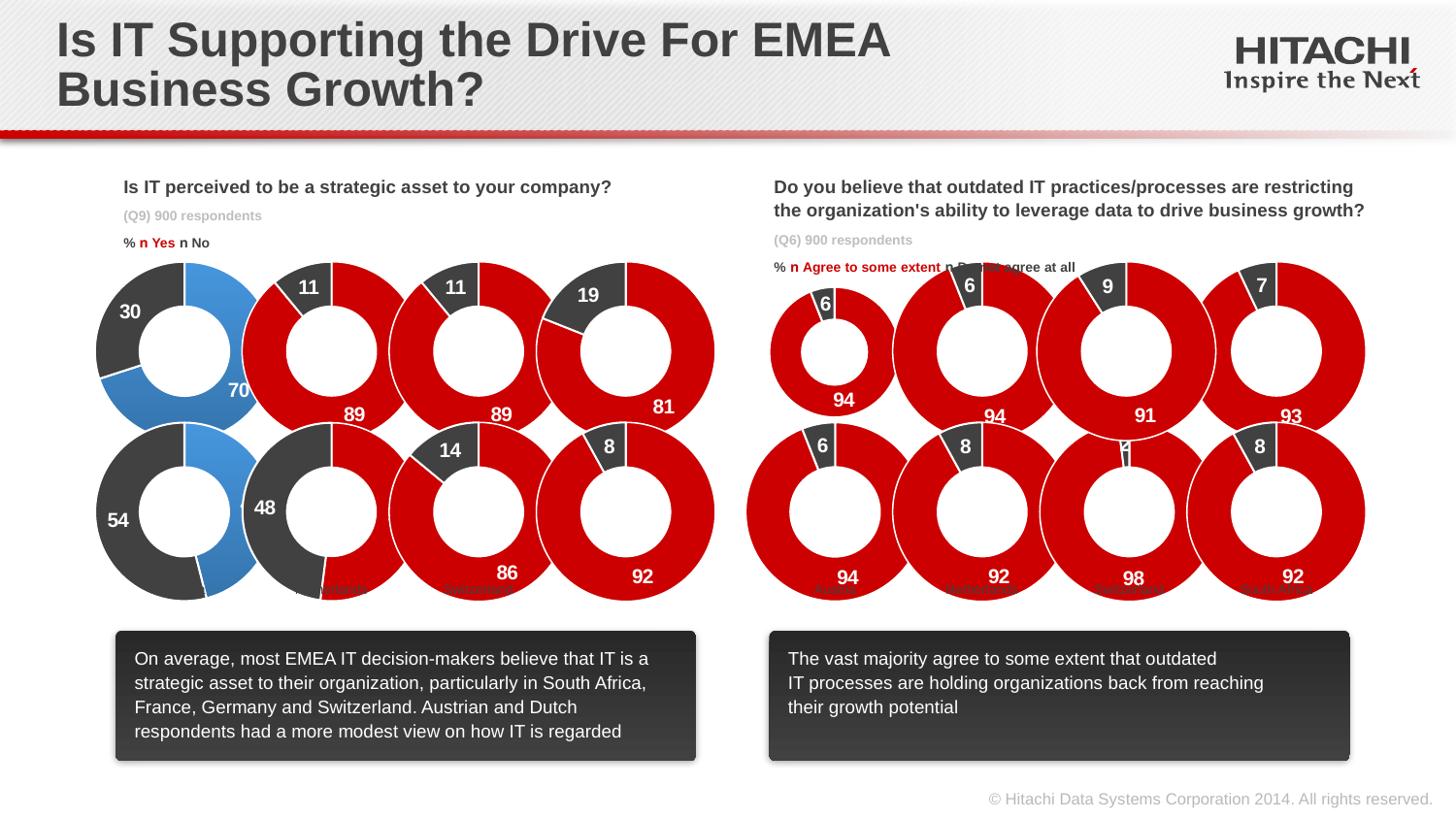
In the chart 'Is IT perceived to be a strategic asset to your company?', what is the 'No' value in the top-left donut? 30 In the chart 'Is IT perceived to be a strategic asset to your company?', which has the larger 'Yes' value: the top-right donut or the bottom-right donut? Bottom-right donut (92) In the chart 'Is IT perceived to be a strategic asset to your company?', how many donut charts are shown? 8 How many respondents are cited for the chart 'Is IT perceived to be a strategic asset to your company?' 900 respondents In the chart about outdated IT practices/processes, what is the lowest 'Agree to some extent' value shown? 91 In the chart about outdated IT practices/processes, what is the 'Do not agree at all' value in the top-left donut? 6 What kind of charts are used on this slide? Donut (pie) charts In the chart about outdated IT practices/processes, what is the 'Agree to some extent' value in the third donut of the bottom row? 98 In the chart 'Is IT perceived to be a strategic asset to your company?', how many entries does the legend list? 2 In the chart about outdated IT practices/processes, what is the highest 'Agree to some extent' value shown? 98 In the chart 'Is IT perceived to be a strategic asset to your company?', what is the difference between the 'Yes' and 'No' values in the top-left donut? 40 In the chart 'Is IT perceived to be a strategic asset to your company?', what is the 'Yes' value in the top-right donut? 81